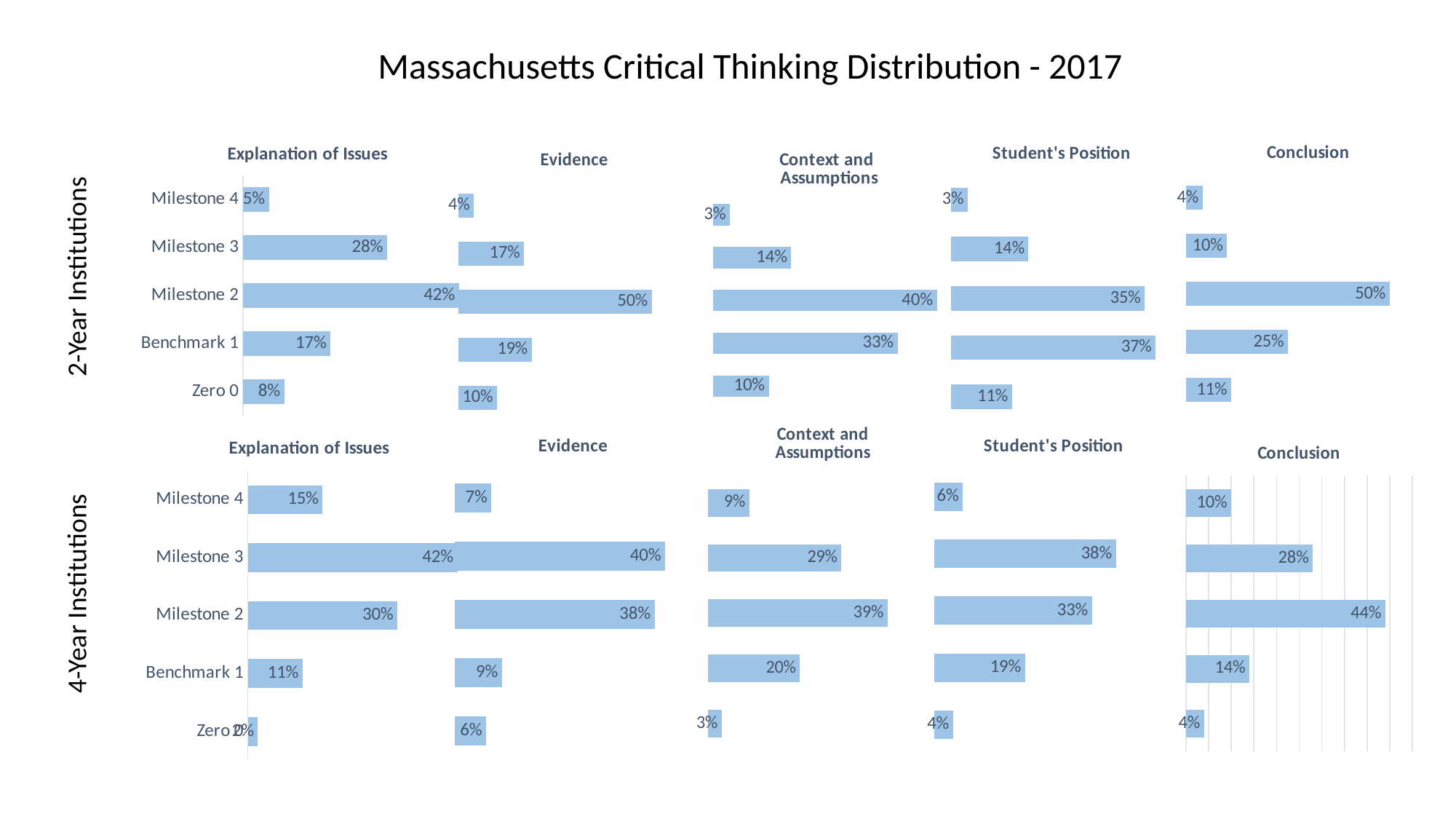
In the 4-Year Institutions Student's Position chart, what is the value for Benchmark 1? 19% In the 2-Year Institutions Student's Position chart, which is larger, Milestone 2 or Benchmark 1? Benchmark 1 What type of chart is used for the 2-Year Institutions Evidence chart? Bar chart In the 4-Year Institutions Conclusion chart, which category has the highest value? Milestone 2 In the 2-Year Institutions Conclusion chart, what is the difference between Milestone 2 and Benchmark 1? 25% In the 2-Year Institutions Context and Assumptions chart, what is the value for Benchmark 1? 33% In the 2-Year Institutions Evidence chart, which category has the highest value? Milestone 2 In the 2-Year Institutions Explanation of Issues chart, what is the value for Milestone 2? 42% In the 4-Year Institutions Explanation of Issues chart, what is the value for Milestone 3? 42% In the 4-Year Institutions Evidence chart, which category has the lowest value? Zero 0 How many categories does each chart on the slide show? 5 In the 4-Year Institutions Context and Assumptions chart, what is the difference between Milestone 2 and Milestone 3? 10%